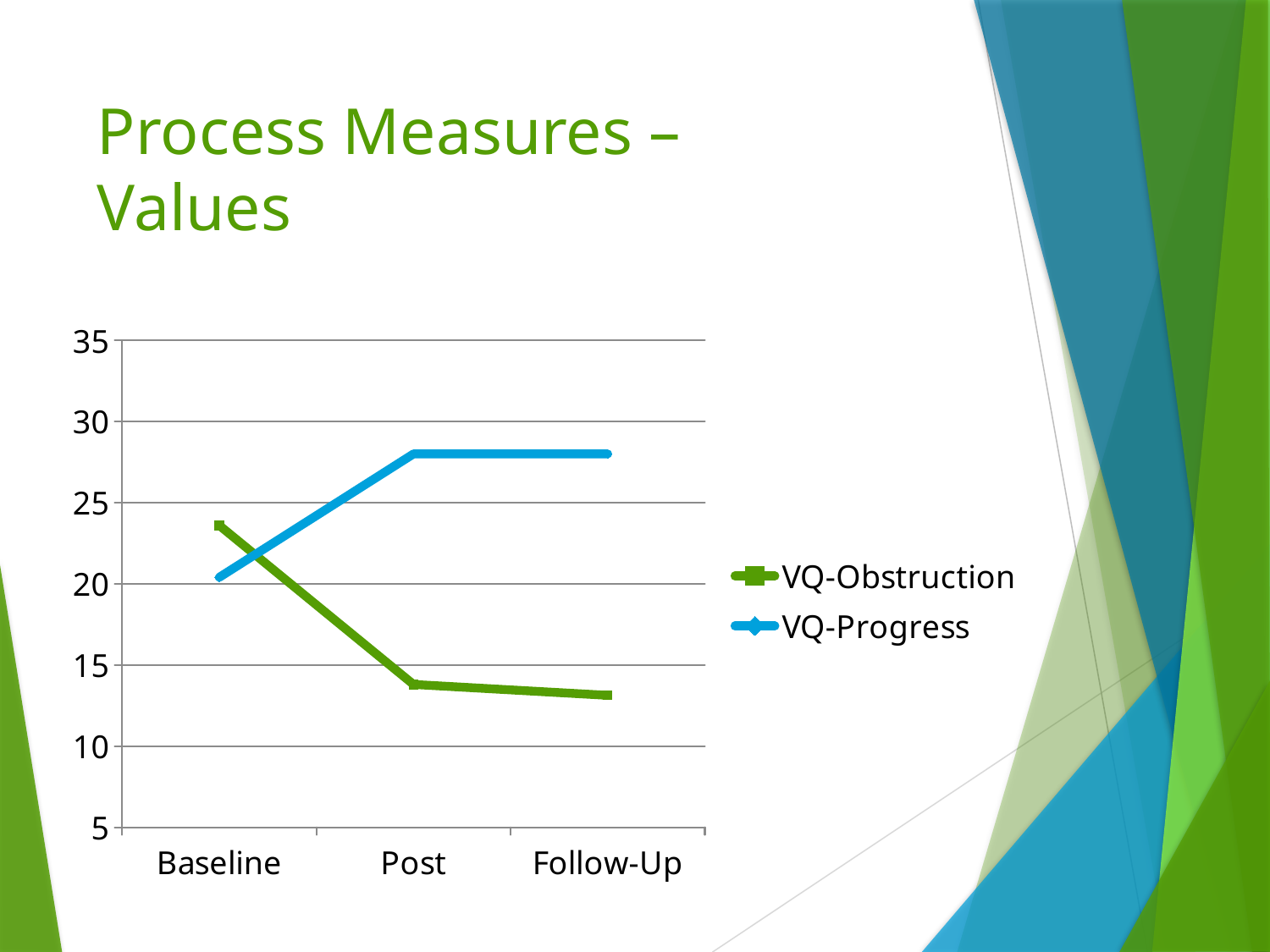
Which series is drawn in green? VQ-Obstruction Does the VQ-Obstruction line rise or fall from Baseline to Follow-Up? fall What kind of chart is shown on the slide? line chart At which category is the VQ-Obstruction value highest? Baseline Does the VQ-Progress line rise or fall from Baseline to Post? rise How many series does the legend list? 2 How many categories are shown on the x axis? 3 Is the VQ-Progress value at Post greater or less than 25? greater Is the VQ-Progress value at Follow-Up greater or less than 30? less Is the VQ-Obstruction value at Follow-Up greater or less than 15? less At Post, which series has the larger value, VQ-Obstruction or VQ-Progress? VQ-Progress